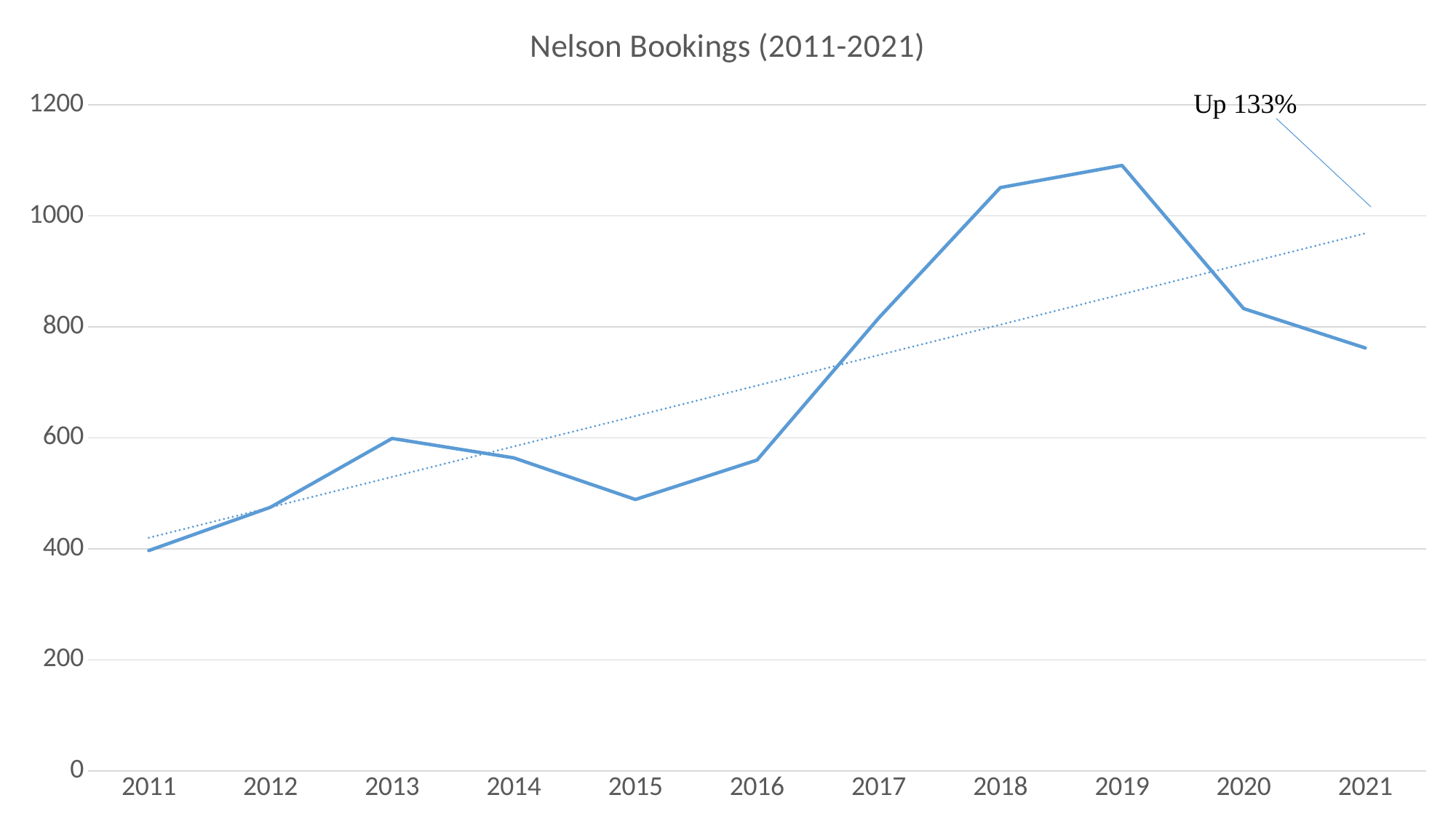
What kind of chart is shown on the slide? line chart Do bookings rise or fall from 2019 to 2021? fall Which year has the highest number of bookings? 2019 What does the text annotation near the top right of the chart say? Up 133% What is the title of the chart? Nelson Bookings (2011-2021) How many years are plotted along the x axis? 11 Is the value for 2017 greater or less than 600? greater Is the value for 2015 greater or less than 600? less Which year has the lowest number of bookings? 2011 Is the value for 2018 greater or less than 1000? greater Which year has more bookings, 2013 or 2015? 2013